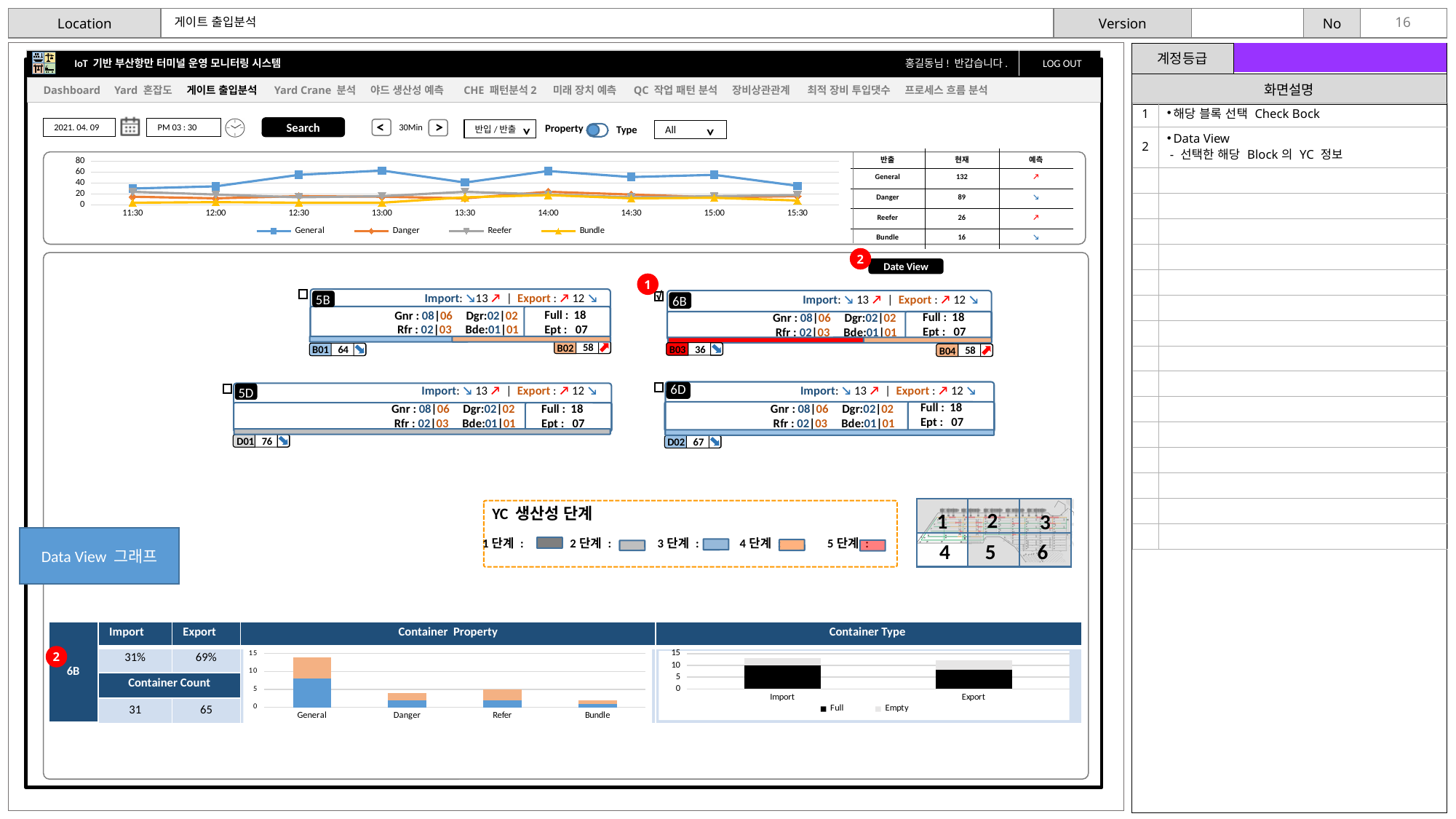
How many series does the legend of the Container Type chart list? 2 In the top line chart, does the General series rise or fall from 11:30 to 12:30? rise In the Container Property chart, which category has the tallest bar? General How many time points are shown on the x axis of the top line chart? 9 In the top line chart, is the value for General at 11:30 greater or less than 40? less How many series does the legend of the top line chart list? 4 In the top line chart, is the value for General at 12:30 greater or less than 40? greater What kind of chart is the chart at the top of the slide showing General, Danger, Reefer and Bundle over time? line chart How many categories are shown on the x axis of the Container Property chart? 4 What kind of chart is the Container Property chart? bar chart In the Container Property chart, is the total bar for General greater or less than 10? greater In the top line chart, which series has the highest values across the time range? General